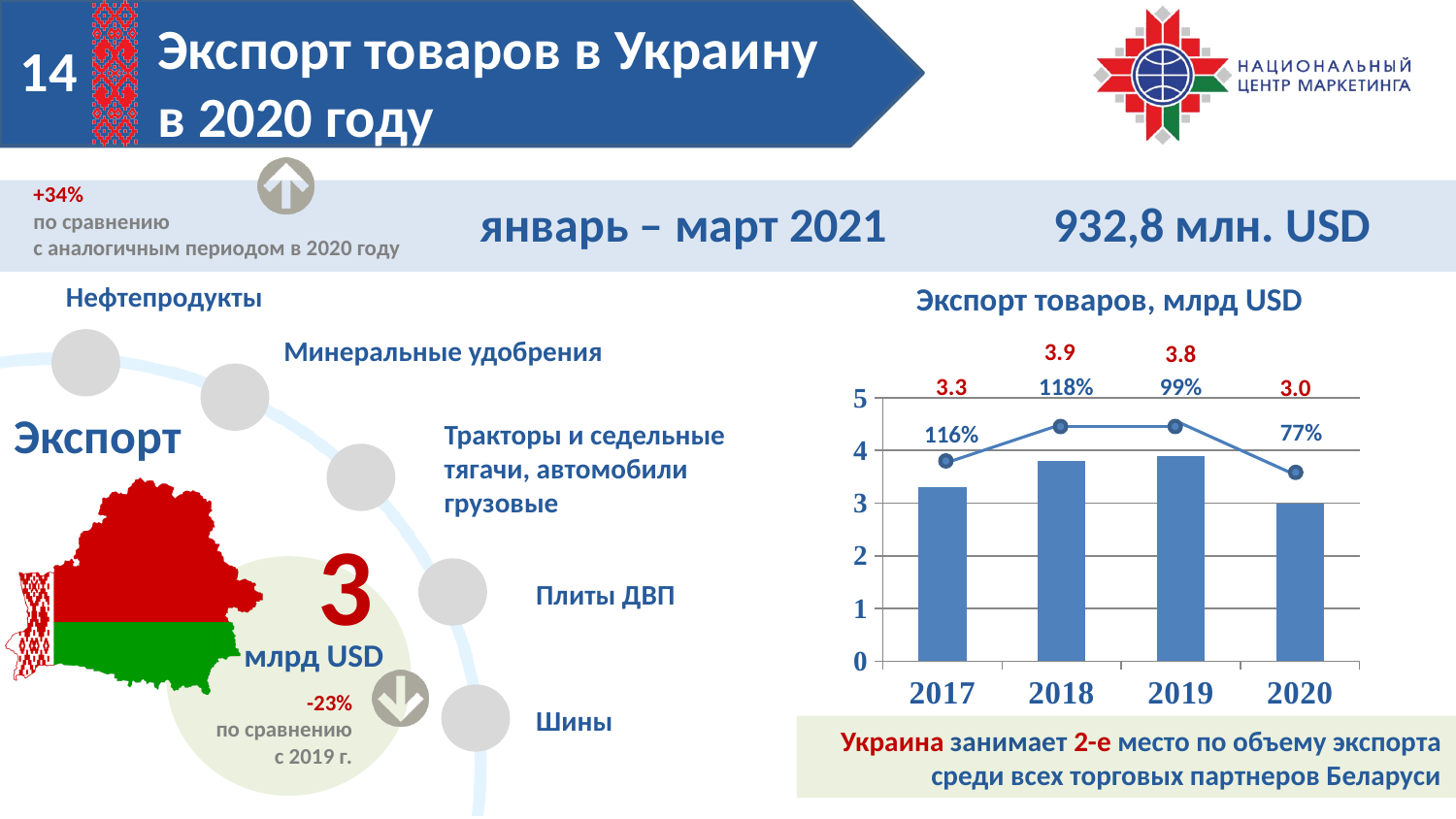
How many years are shown on the x axis of the chart? 4 Does the export value rise or fall from 2019 to 2020? Fall Which year has the lowest export value in the chart? 2020 What is the title of the chart on the right side of the slide? Экспорт товаров, млрд USD What type of chart is used to show export values by year? Bar chart with a line What is the export value shown for 2018 in the chart 'Экспорт товаров, млрд USD'? 3.9 Which year has a larger export value, 2017 or 2019? 2019 What is the export value shown for 2020 in the chart? 3.0 What percentage is shown above the 2017 bar in the chart? 116% What percentage is shown for 2019 in the chart? 99%